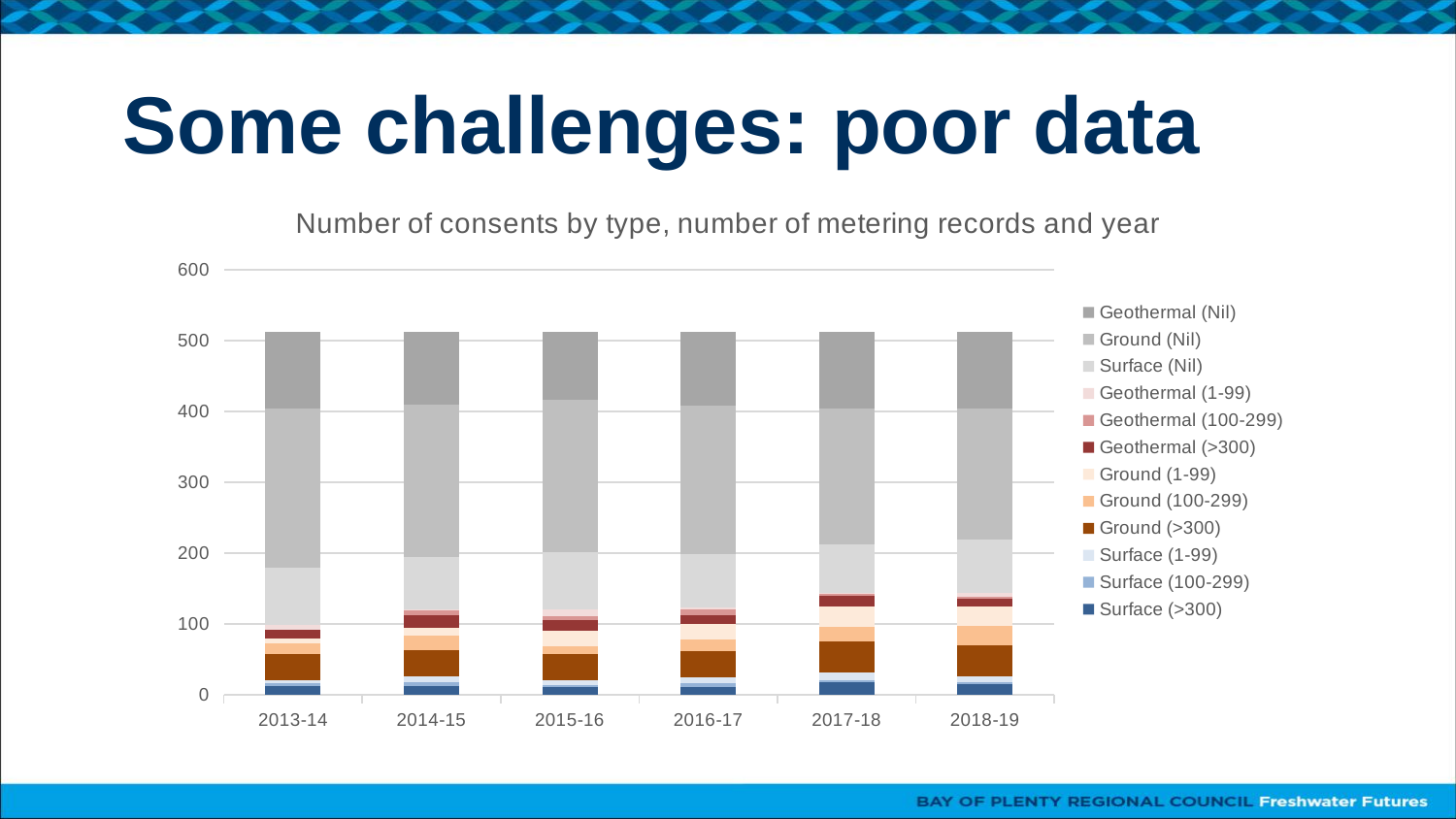
What is the title of the chart? Number of consents by type, number of metering records and year Is the top of the Ground (Nil) segment in the 2015-16 bar greater or less than 400? greater What is the highest value shown on the y axis? 600 Is the top of the Ground (>300) segment in the 2013-14 bar greater or less than 100? less Is the total height of the 2018-19 bar greater or less than 600? less What kind of chart is shown on the slide? Stacked bar chart Which year is the first category on the x axis? 2013-14 How many series does the chart's legend list? 12 How many years (categories) are shown on the x axis of the chart? 6